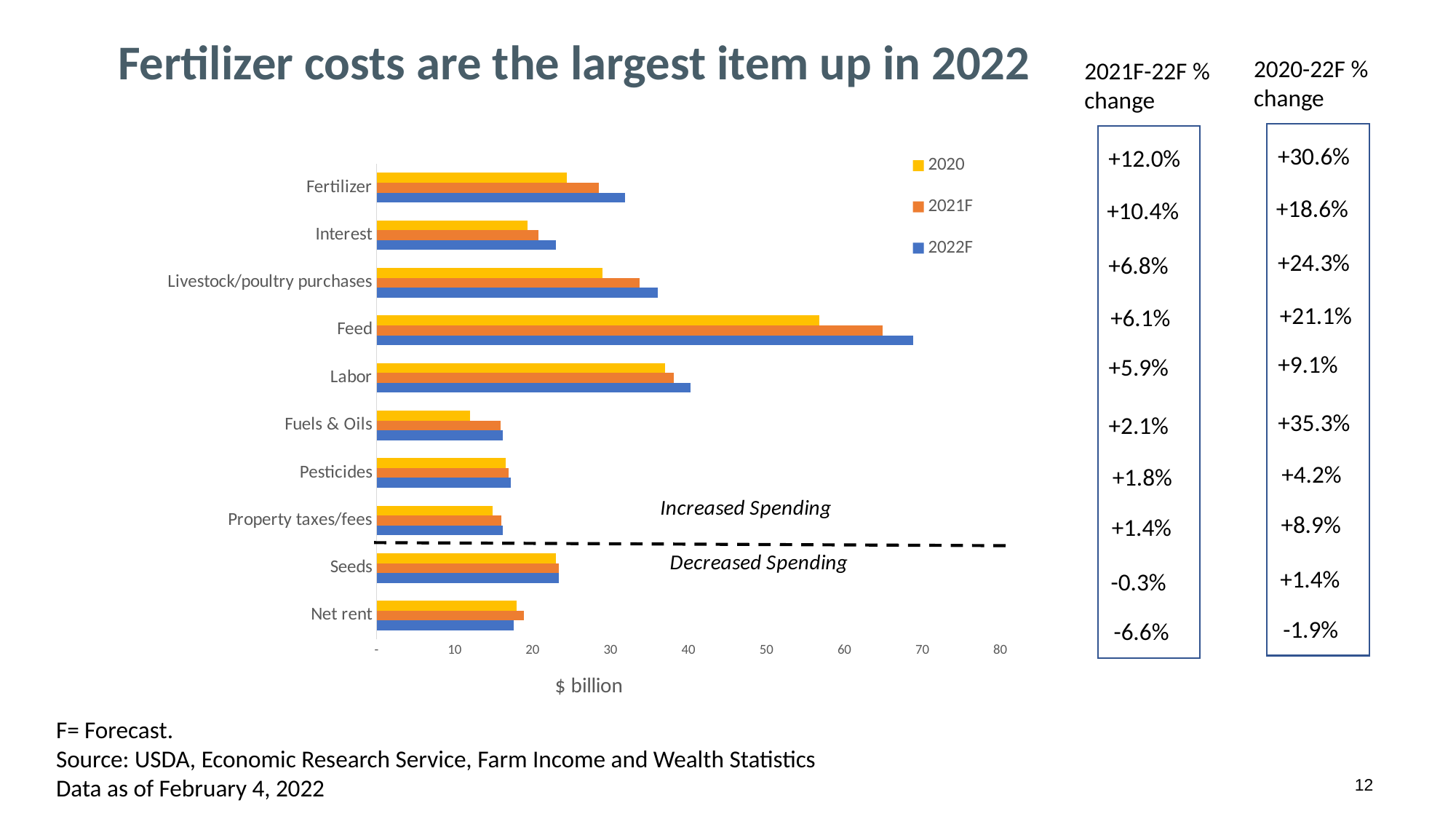
Is the 2022F value for Net rent greater or less than 20? less What unit is shown on the chart's horizontal axis label? $ billion How many expense categories are plotted on the chart? 10 What kind of chart is shown on the slide? bar chart Is the 2020 value for Labor greater or less than 40? less How many series does the chart legend list? 3 Do the Fertilizer bars rise or fall from 2020 to 2022F? rise Which is larger, the 2022F value for Fertilizer or the 2022F value for Interest? Fertilizer Which expense category has the highest 2022F value? Feed What is the 2020-22F % change shown for Fertilizer? +30.6% Is the 2022F value for Feed greater or less than 60? greater Which expense category has the lowest 2020 value? Fuels & Oils